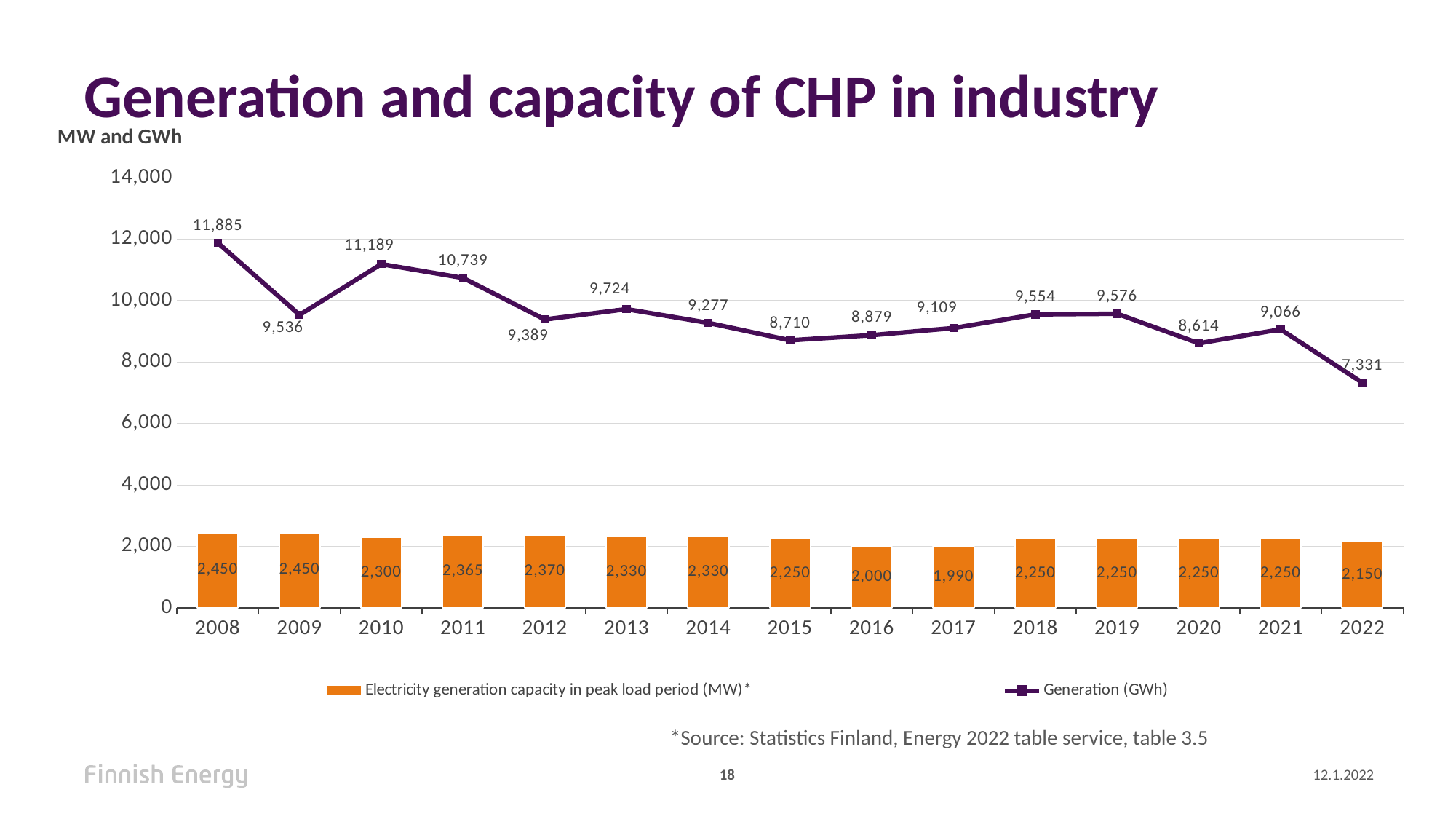
Which year has the lowest Generation (GWh)? 2022 Is the Generation (GWh) value for 2021 greater or less than 8,000? greater What is the title of the chart? Generation and capacity of CHP in industry Which year has the highest Generation (GWh)? 2008 What is the Generation (GWh) value for 2008? 11,885 What is the Generation (GWh) value for 2022? 7,331 How many series does the legend list? 2 What is the Electricity generation capacity in peak load period (MW) for 2017? 1,990 Which year has the lowest Electricity generation capacity in peak load period (MW)? 2017 Is the Generation (GWh) for 2018 larger than for 2019? No, 2019 is larger What is the difference in Generation (GWh) between 2008 and 2009? 2,349 How many years are shown on the x axis? 15